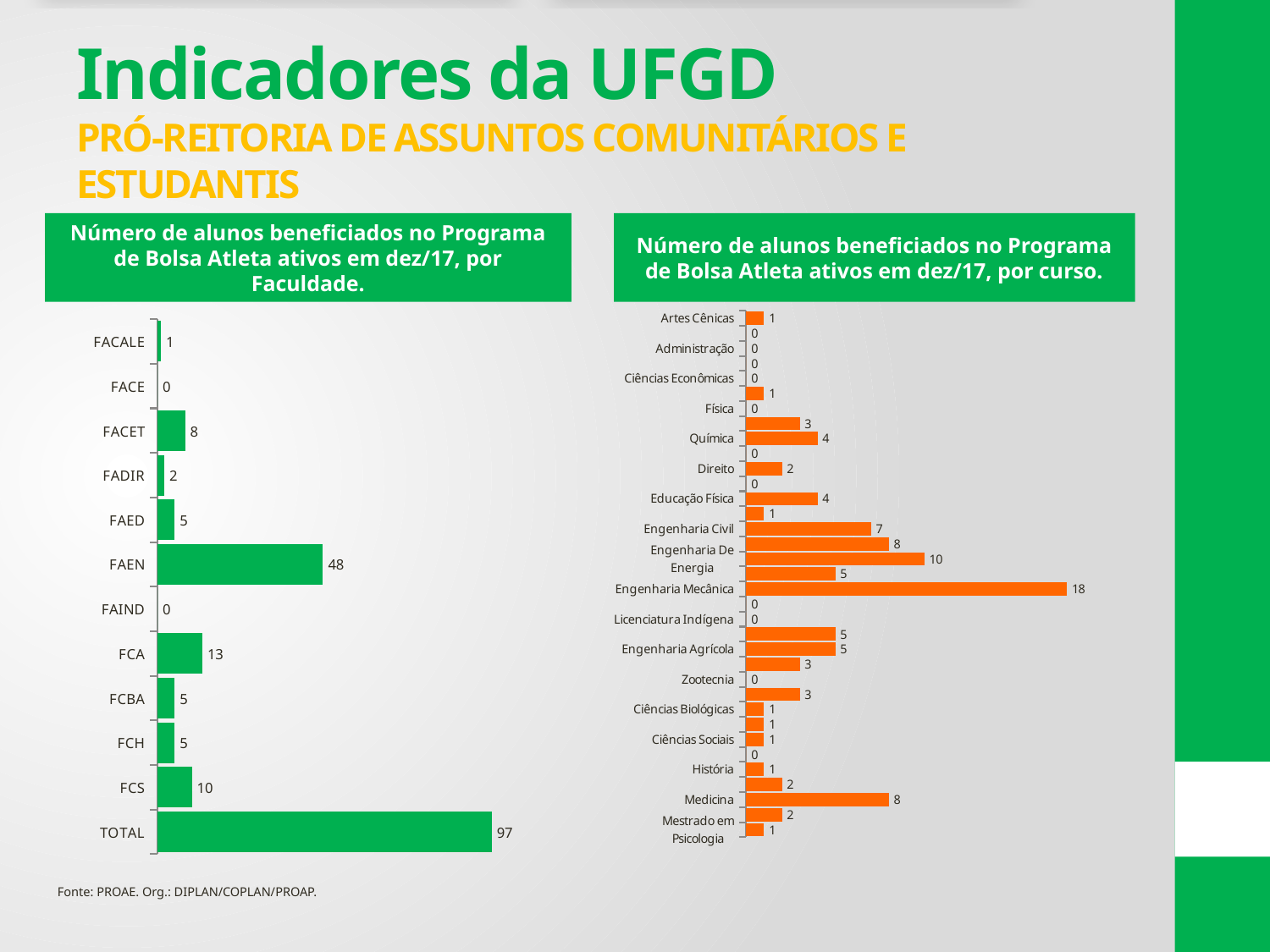
In the chart by Faculdade (left), which is larger, FACET or FCS? FCS In the chart by Faculdade (left), which faculties have a value of 0? FACE and FAIND What type of chart is used in the chart by Faculdade (left)? Bar chart In the chart by curso (right), which course has the highest number of students? Engenharia Mecânica What colour are the bars in the chart by curso (right)? Orange In the chart by Faculdade (left), which faculty (excluding TOTAL) has the highest number of students? FAEN In the chart by Faculdade (left), how many students does FAEN have? 48 In the chart by Faculdade (left), what is the difference between FAEN and FCA? 35 In the chart by Faculdade (left), what is the TOTAL value shown? 97 In the chart by curso (right), what is the value for Engenharia Mecânica? 18 In the chart by Faculdade (left), what is the value for FCA? 13 In the chart by Faculdade (left), how many bars are shown, including TOTAL? 12